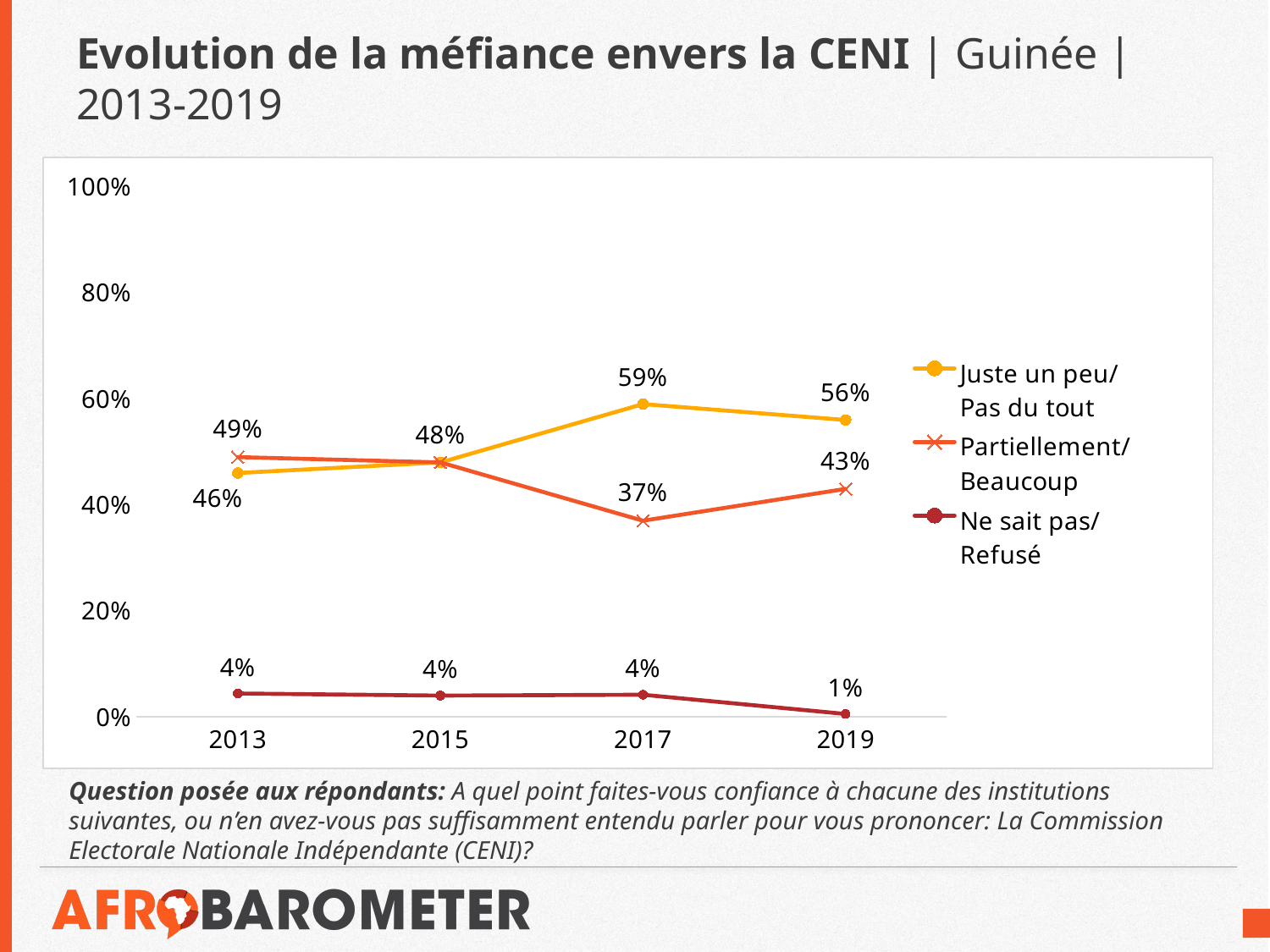
What is the difference between Juste un peu/Pas du tout and Partiellement/Beaucoup in 2017? 22 percentage points Is the value for Juste un peu/Pas du tout in 2019 greater or less than 40%? greater What kind of chart is shown on the slide? Line chart Which series has the larger value in 2013, Juste un peu/Pas du tout or Partiellement/Beaucoup? Partiellement/Beaucoup In which year is the Partiellement/Beaucoup series lowest? 2017 How many years are shown on the x axis? 4 What is the value for Juste un peu/Pas du tout in 2017? 59% In which year is the Juste un peu/Pas du tout series highest? 2017 What is the value for Partiellement/Beaucoup in 2013? 49% How many series does the legend list? 3 What is the value for Partiellement/Beaucoup in 2019? 43% What is the value for Ne sait pas/Refusé in 2019? 1%